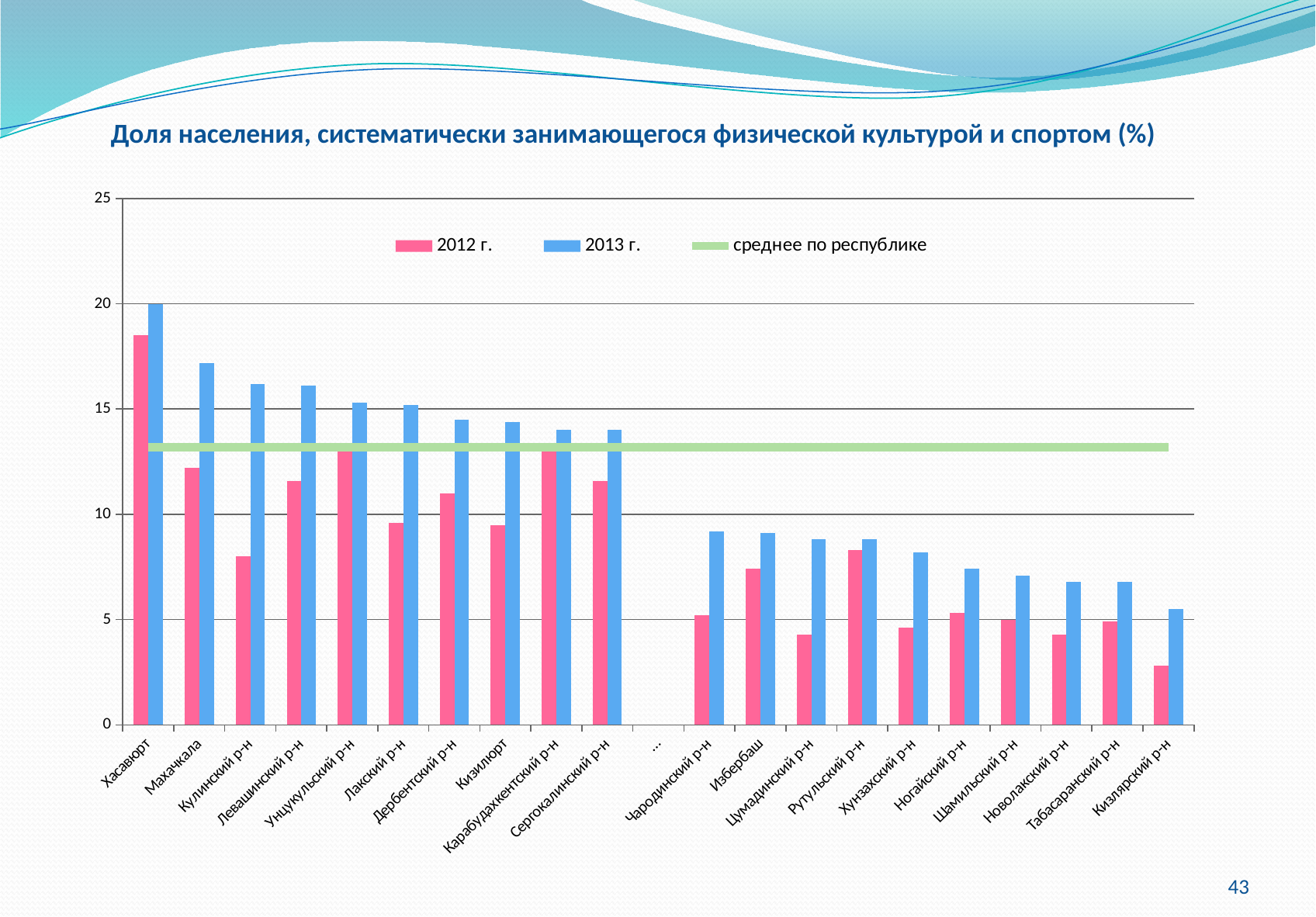
Is the 2013 г. value for Чародинский р-н greater or less than 10? less Which category has the highest value for the 2013 г. series? Хасавюрт What kind of chart is shown on the slide? bar chart Is the 2012 г. value for Кулинский р-н greater or less than 10? less Which is larger: the 2012 г. value for Хасавюрт or the 2012 г. value for Махачкала? Хасавюрт Do the 2013 г. values generally rise or fall from left to right along the x axis? fall Which category has the lowest value for the 2012 г. series? Кизлярский р-н Is the 2012 г. value for Хасавюрт greater or less than 15? greater Which is larger: the 2013 г. value for Махачкала or the 2013 г. value for Избербаш? Махачкала What is the title of the chart? Доля населения, систематически занимающегося физической культурой и спортом (%) How many series does the legend list? 3